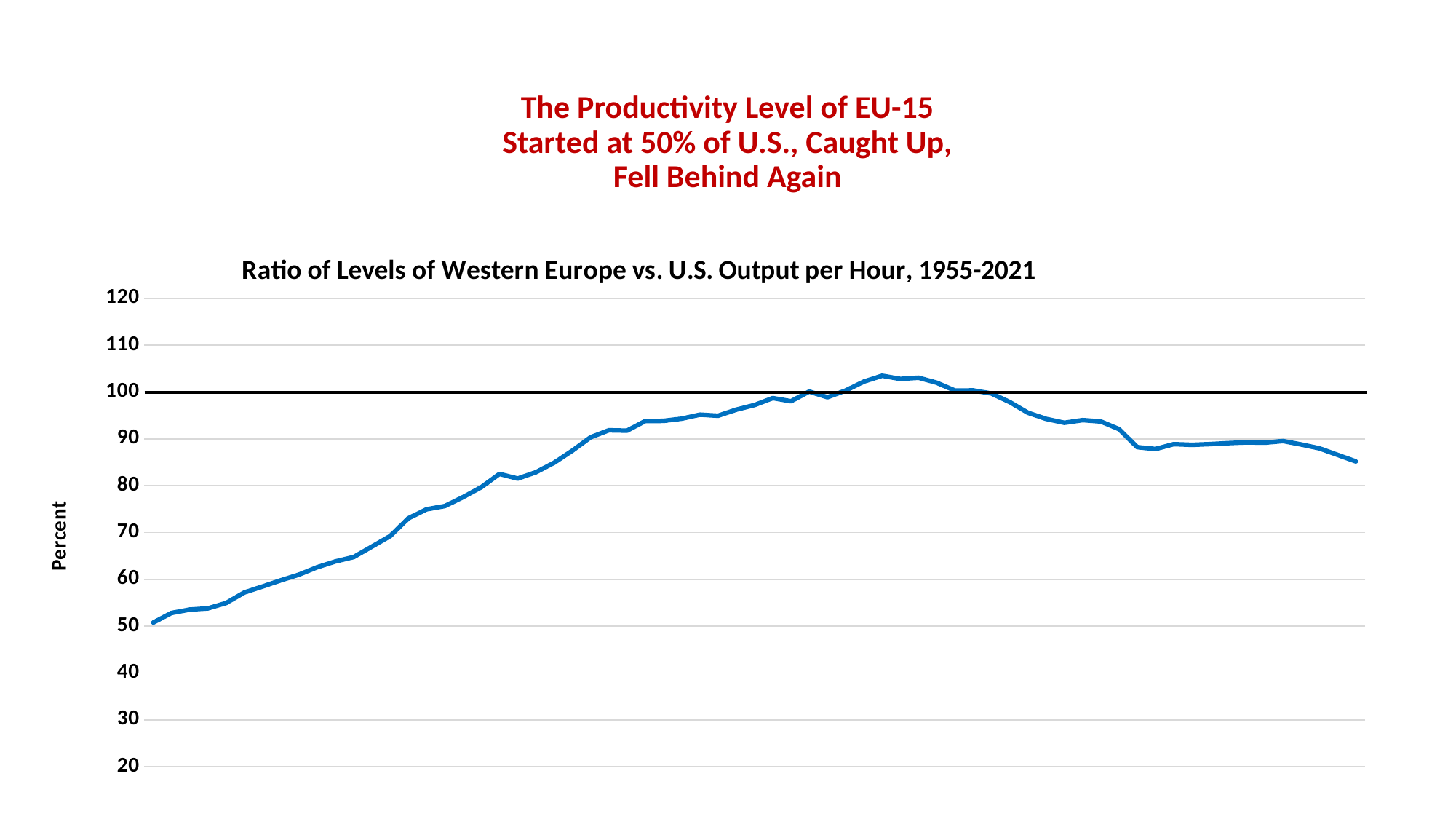
Is the highest point of the line greater or less than 110? less At what value on the vertical axis is the horizontal black reference line drawn? 100 What is the title of the chart? Ratio of Levels of Western Europe vs. U.S. Output per Hour, 1955-2021 Is the value at the end of the line (right end) greater or less than 90? less What is the lowest tick value shown on the vertical axis? 20 Is the value at the right end of the line higher or lower than the value at the left end? higher What kind of chart is shown on the slide? Line chart Does the line generally rise or fall over the first half of the chart? rise Is the highest point of the line greater or less than 100? greater What is the label on the vertical axis of the chart? Percent How many lines are plotted on the chart? 1